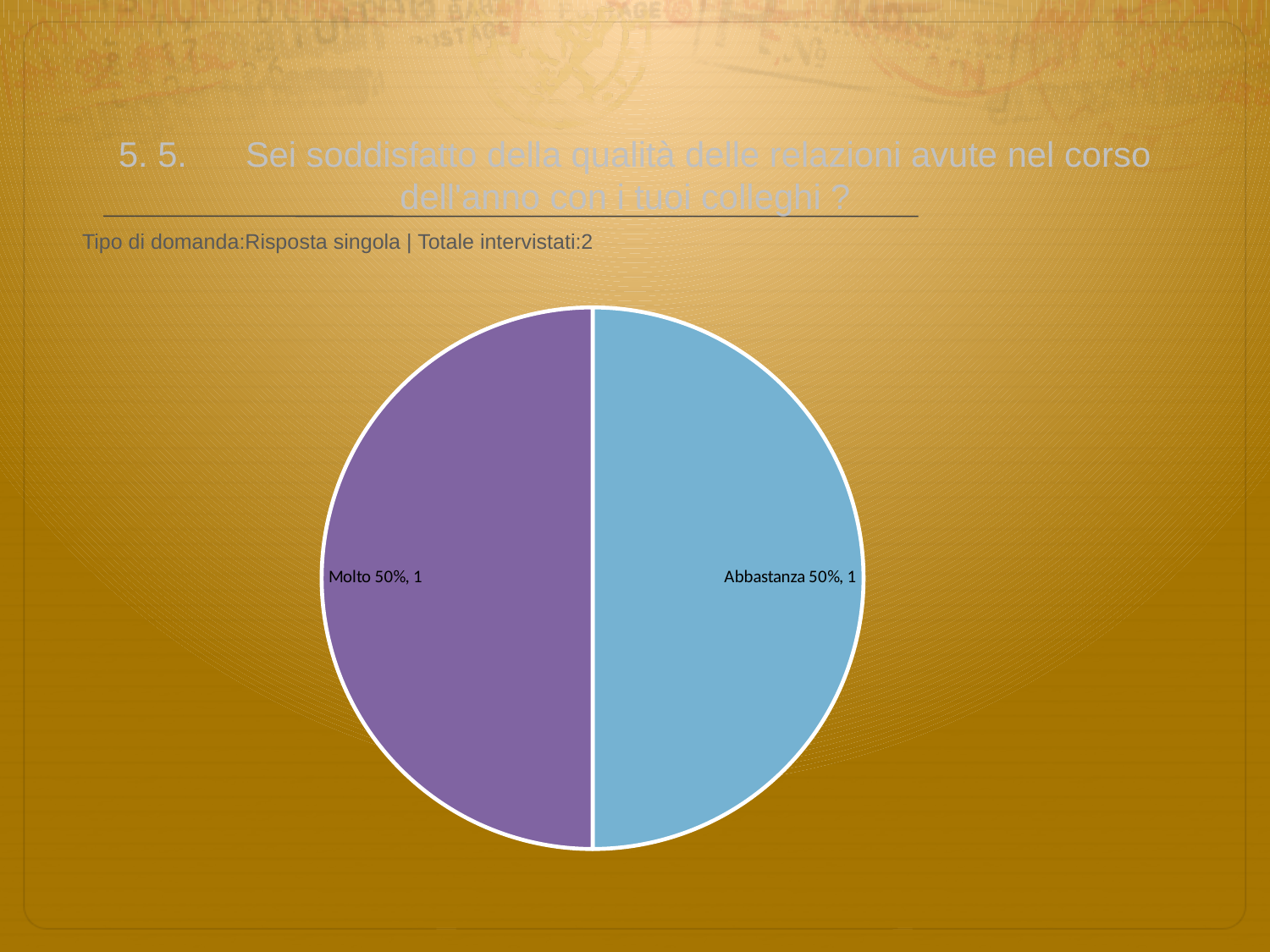
What is the total number of respondents across both slices of the pie chart? 2 What colour is the Molto slice of the pie chart? purple How many respondents chose Molto according to the data label? 1 What kind of chart is shown on the slide? pie chart How many respondents chose Abbastanza according to the data label? 1 Are the shares of the Molto and Abbastanza slices equal? yes How many slices does the pie chart have? 2 What colour is the Abbastanza slice of the pie chart? light blue What share of the pie does the Molto slice represent? 50% What share of the pie does the Abbastanza slice represent? 50%